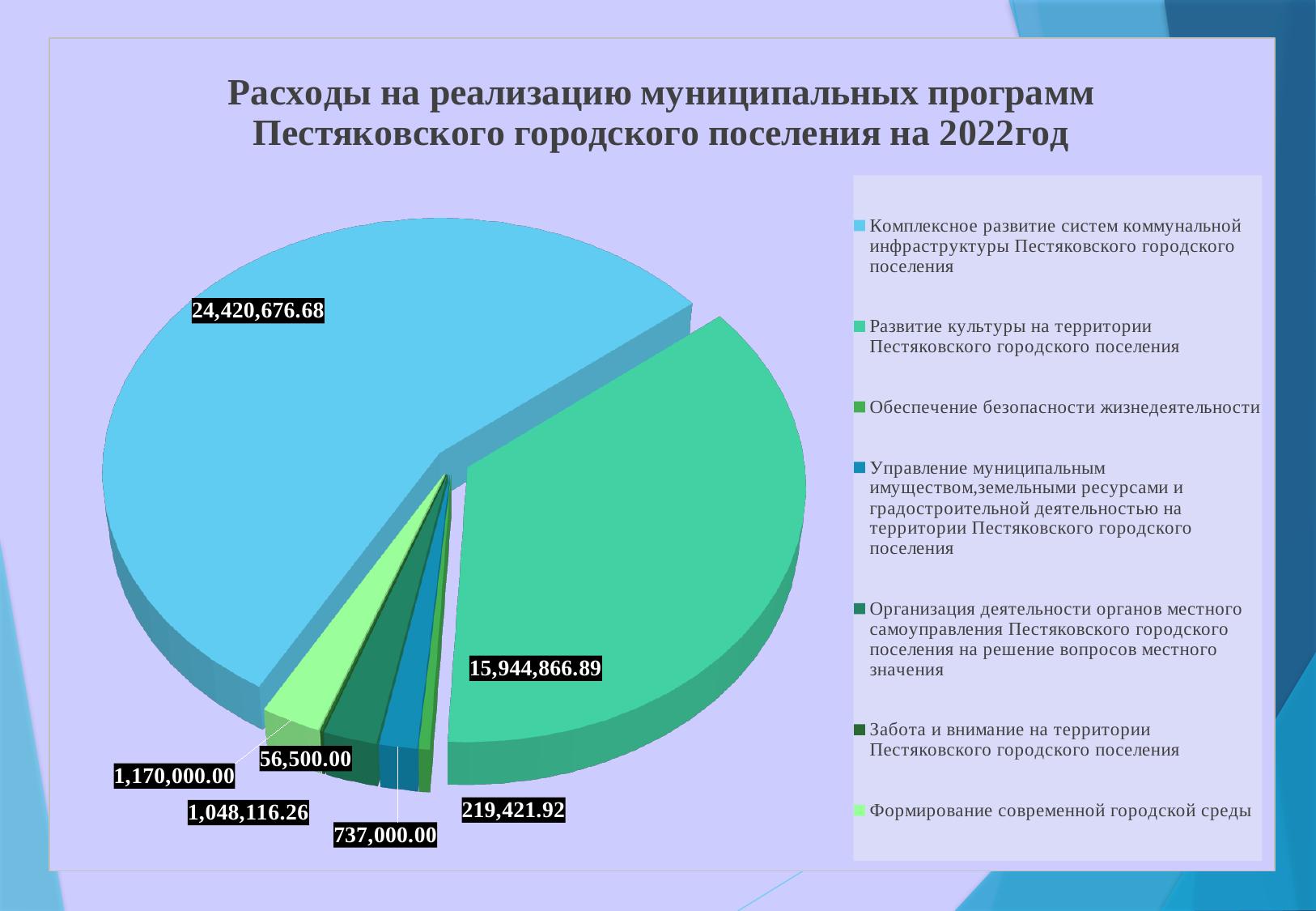
What is the value of the smallest slice of the pie chart? 56,500.00 What is the difference between the two largest slices, 24,420,676.68 and 15,944,866.89? 8,475,809.79 What is the value for «Развитие культуры на территории Пестяковского городского поселения»? 15,944,866.89 What is the value of the largest slice of the pie chart? 24,420,676.68 How many slices does the pie chart have? 7 Which legend entry is shown in light blue? Комплексное развитие систем коммунальной инфраструктуры Пестяковского городского поселения How many entries does the legend list? 7 What kind of chart is shown on the slide? Pie chart What is the value for «Формирование современной городской среды»? 1,170,000.00 What is the value for «Комплексное развитие систем коммунальной инфраструктуры Пестяковского городского поселения»? 24,420,676.68 Which is larger: the slice labelled 1,170,000.00 or the slice labelled 1,048,116.26? 1,170,000.00 What is the title of the chart? Расходы на реализацию муниципальных программ Пестяковского городского поселения на 2022год